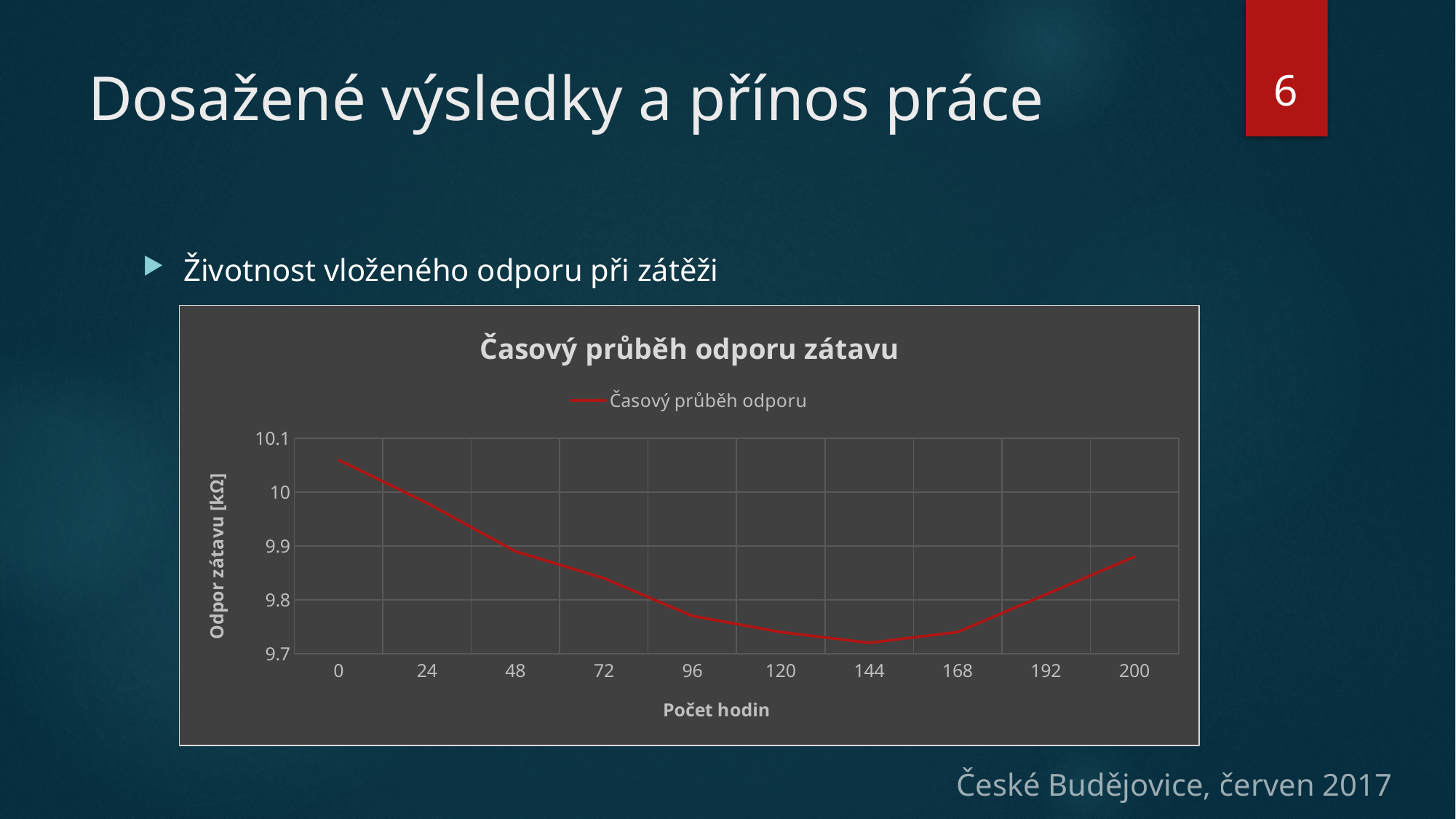
Is the value at 96 hours greater or less than 9.8? less Is the value at 200 hours greater or less than 9.8? greater Does the resistance rise or fall between 0 and 144 hours? fall At which number of hours is the resistance highest? 0 At which number of hours is the resistance lowest? 144 Is the value at 144 hours greater or less than 9.8? less What is the title of the chart? Časový průběh odporu zátavu How many series does the legend list? 1 How many x-axis categories (hour values) are shown on the chart? 10 Which is larger, the value at 0 hours or the value at 200 hours? 0 hours What kind of chart is shown on the slide? line chart